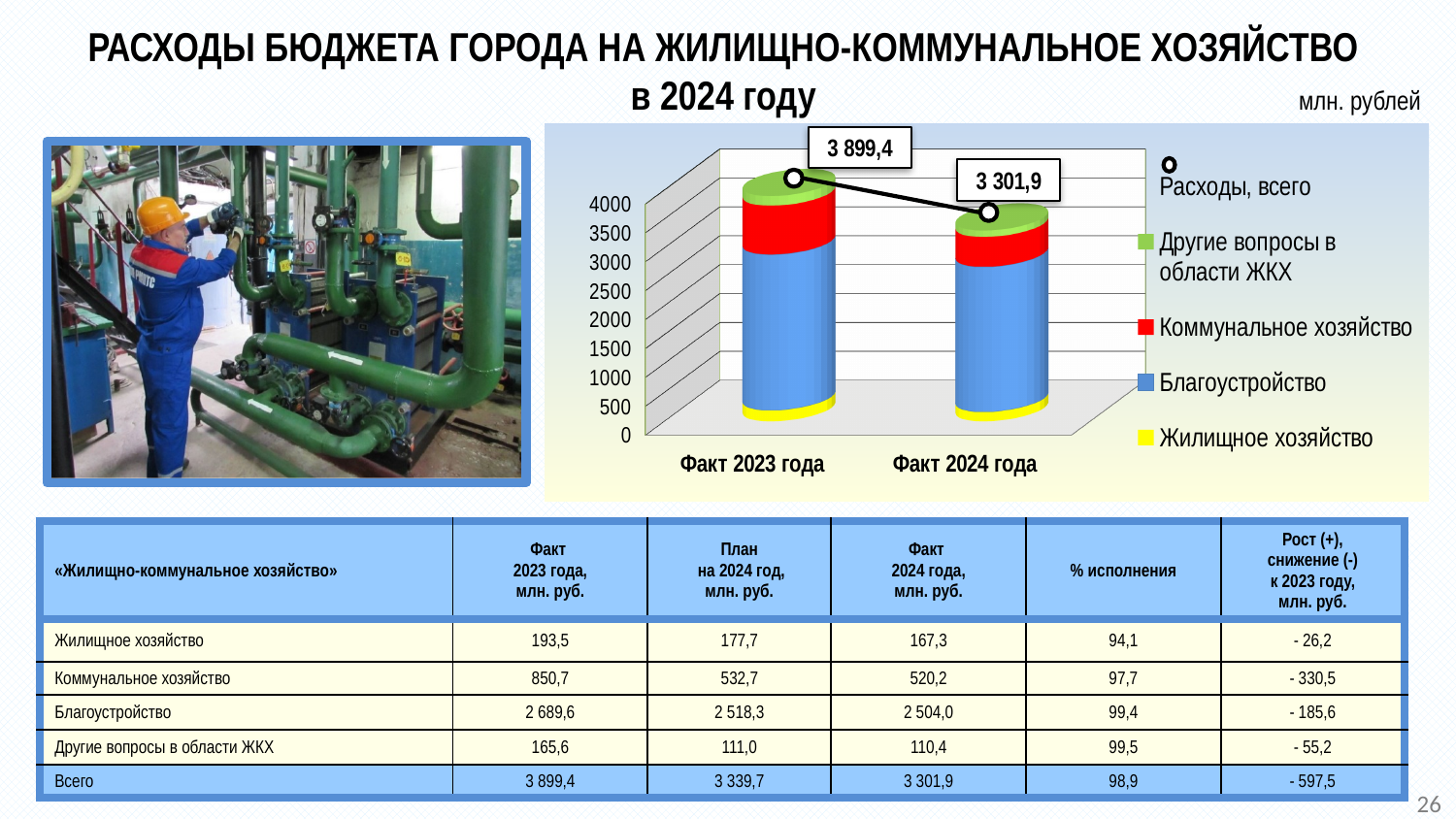
Is the total for Факт 2023 года greater or less than 3500? greater What is the difference between the total for Факт 2023 года and the total for Факт 2024 года? 597,5 How many categories are shown on the x axis of the chart? 2 Which category has the lower total expenditure on the chart? Факт 2024 года What kind of chart is shown on the slide? bar chart Which category has the higher total expenditure, Факт 2023 года or Факт 2024 года? Факт 2023 года What is the value of the 'Расходы, всего' data label for Факт 2023 года? 3 899,4 What is the value of the 'Расходы, всего' data label for Факт 2024 года? 3 301,9 Is the total for Факт 2024 года greater or less than 3500? less Which colour represents 'Коммунальное хозяйство' in the chart legend? red How many entries does the chart legend list? 5 Do total expenditures rise or fall from Факт 2023 года to Факт 2024 года? fall